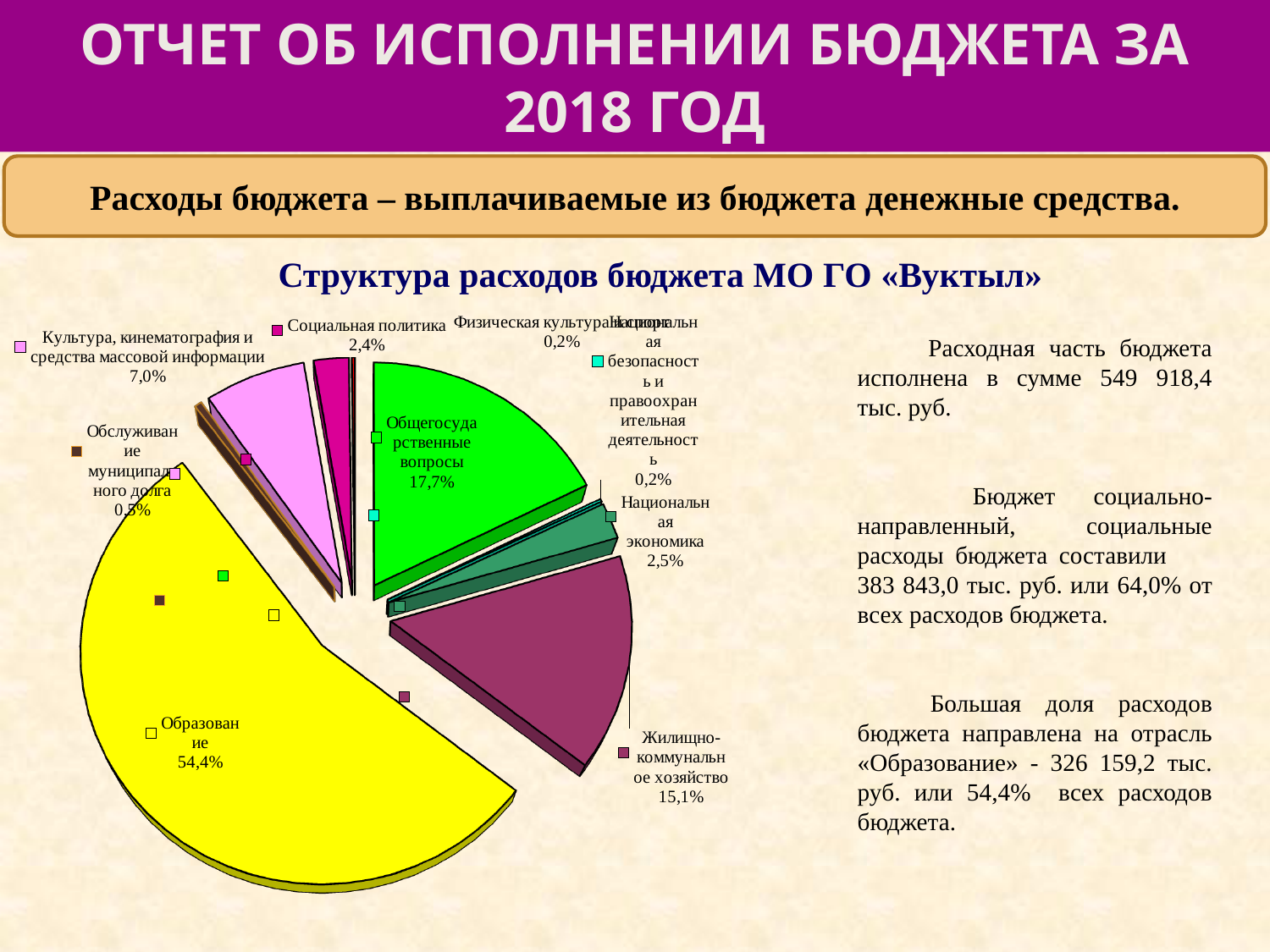
How many slices does the pie chart have? 9 What is the value shown for Жилищно-коммунальное хозяйство? 15,1% Which category has the largest slice of the pie? Образование What is the value shown for Национальная экономика? 2,5% What is the value shown for Культура, кинематография и средства массовой информации? 7,0% What share of the pie does Образование have? 54,4% What is the value shown for Общегосударственные вопросы? 17,7% What kind of chart is shown on the slide? pie chart What is the difference between the shares of Образование and Общегосударственные вопросы? 36,7% What is the value shown for Социальная политика? 2,4% Which is larger, the share of Общегосударственные вопросы or the share of Жилищно-коммунальное хозяйство? Общегосударственные вопросы What is the title of the chart? Структура расходов бюджета МО ГО «Вуктыл»